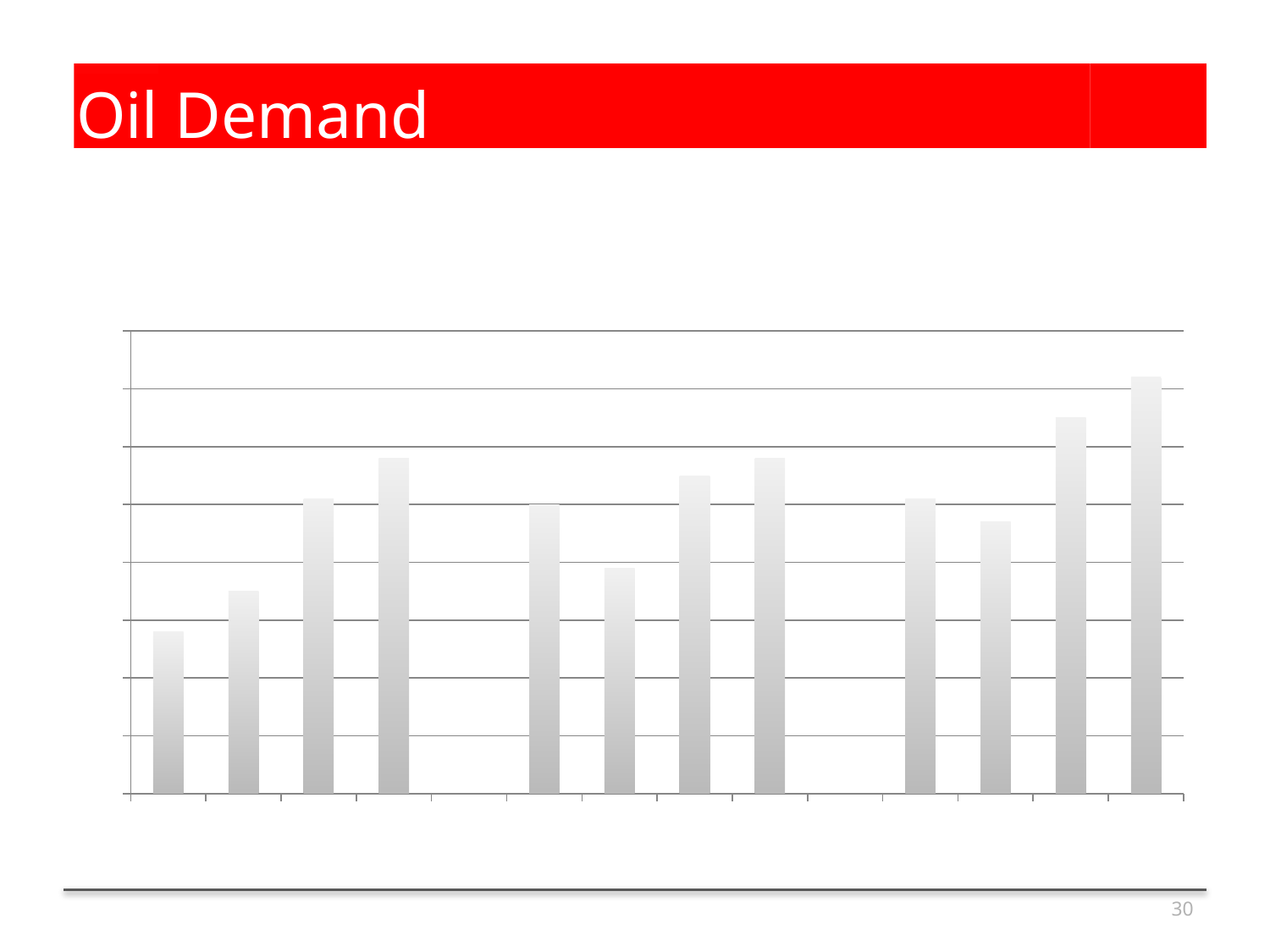
Which bar is the tallest in the chart? the rightmost bar What kind of chart is shown on the slide? bar chart What is the title of the slide containing the chart? Oil Demand Overall, do the bar heights rise or fall from left to right across the chart? rise Is the rightmost bar taller or shorter than the leftmost bar? taller Does the chart display a legend? No How many bars are plotted in the chart? 12 Which bar is the shortest in the chart? the leftmost bar